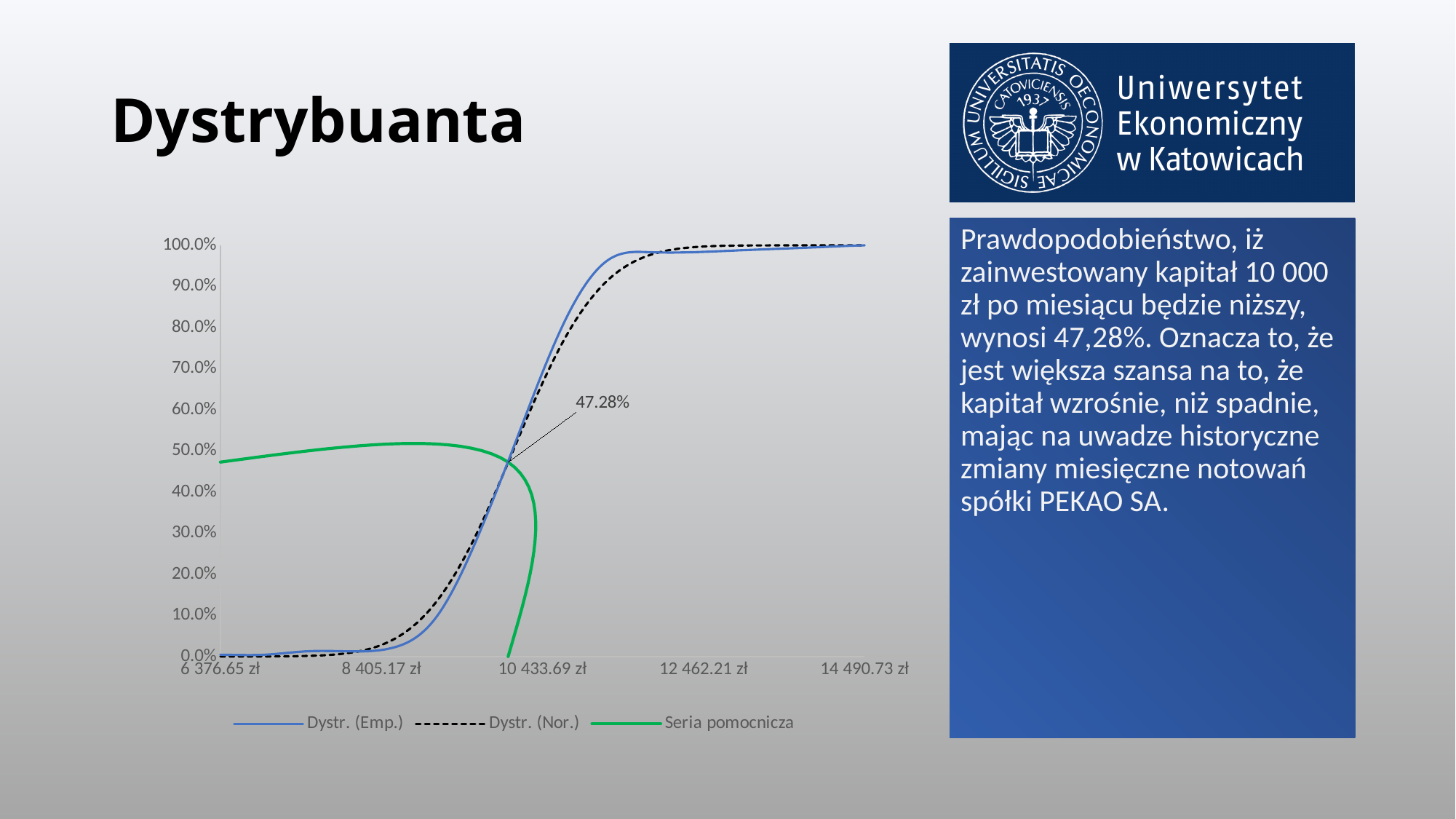
Does the Dystr. (Emp.) series rise or fall as the x-axis values increase? rise Is the value of Dystr. (Emp.) at 12 462.21 zł greater or less than 90.0%? greater What value is printed as a data label on the chart? 47.28% Is the value of Seria pomocnicza at 6 376.65 zł greater or less than 40.0%? greater How many series does the chart legend list? 3 What is the highest value shown on the y axis? 100.0% Is the value of Dystr. (Nor.) at 8 405.17 zł greater or less than 10.0%? less How many labelled tick marks are shown on the x axis? 5 What colour is the Seria pomocnicza line? green What is the first label on the x axis? 6 376.65 zł What are the three series named in the chart legend? Dystr. (Emp.), Dystr. (Nor.), Seria pomocnicza What kind of chart is shown on the slide? line chart